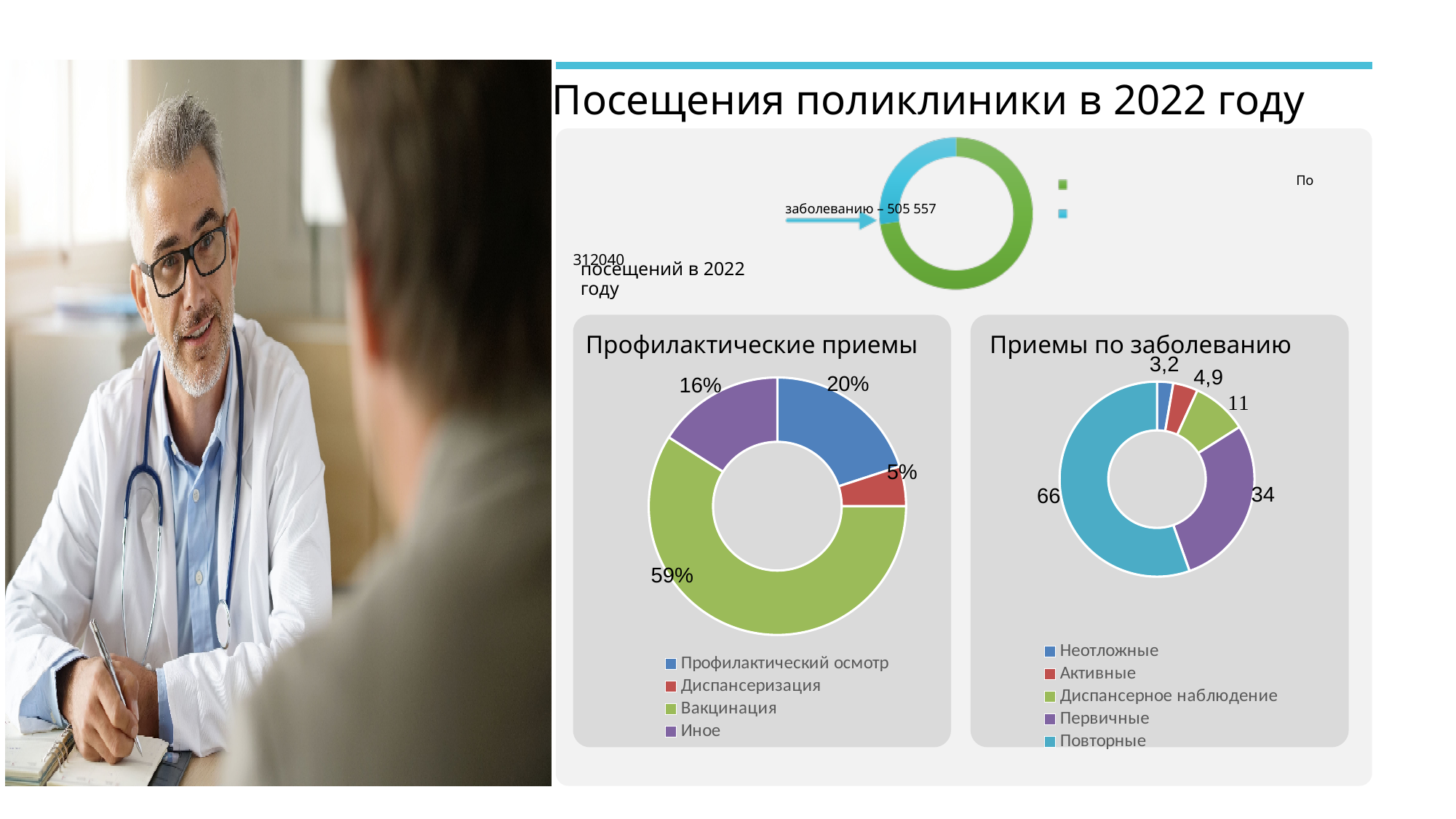
How many categories does the legend of the 'Профилактические приемы' chart list? 4 In the 'Профилактические приемы' chart, what share is labelled for Диспансеризация? 5% In the 'Приемы по заболеванию' chart, what is the difference between Повторные and Первичные? 32 In the 'Профилактические приемы' chart, which category has the largest share? Вакцинация In the 'Приемы по заболеванию' chart, what value is labelled for Неотложные? 3,2 In the 'Профилактические приемы' chart, how many percentage points larger is Профилактический осмотр than Иное? 4 In the 'Приемы по заболеванию' chart, which category has the largest value? Повторные In the 'Приемы по заболеванию' chart, what value is labelled for Повторные? 66 In the 'Профилактические приемы' chart, which category has the smallest share? Диспансеризация What kind of chart is 'Приемы по заболеванию'? Pie (donut) chart In the 'Приемы по заболеванию' chart, which is larger: Первичные or Диспансерное наблюдение? Первичные In the 'Профилактические приемы' chart, what share is labelled for Вакцинация? 59%